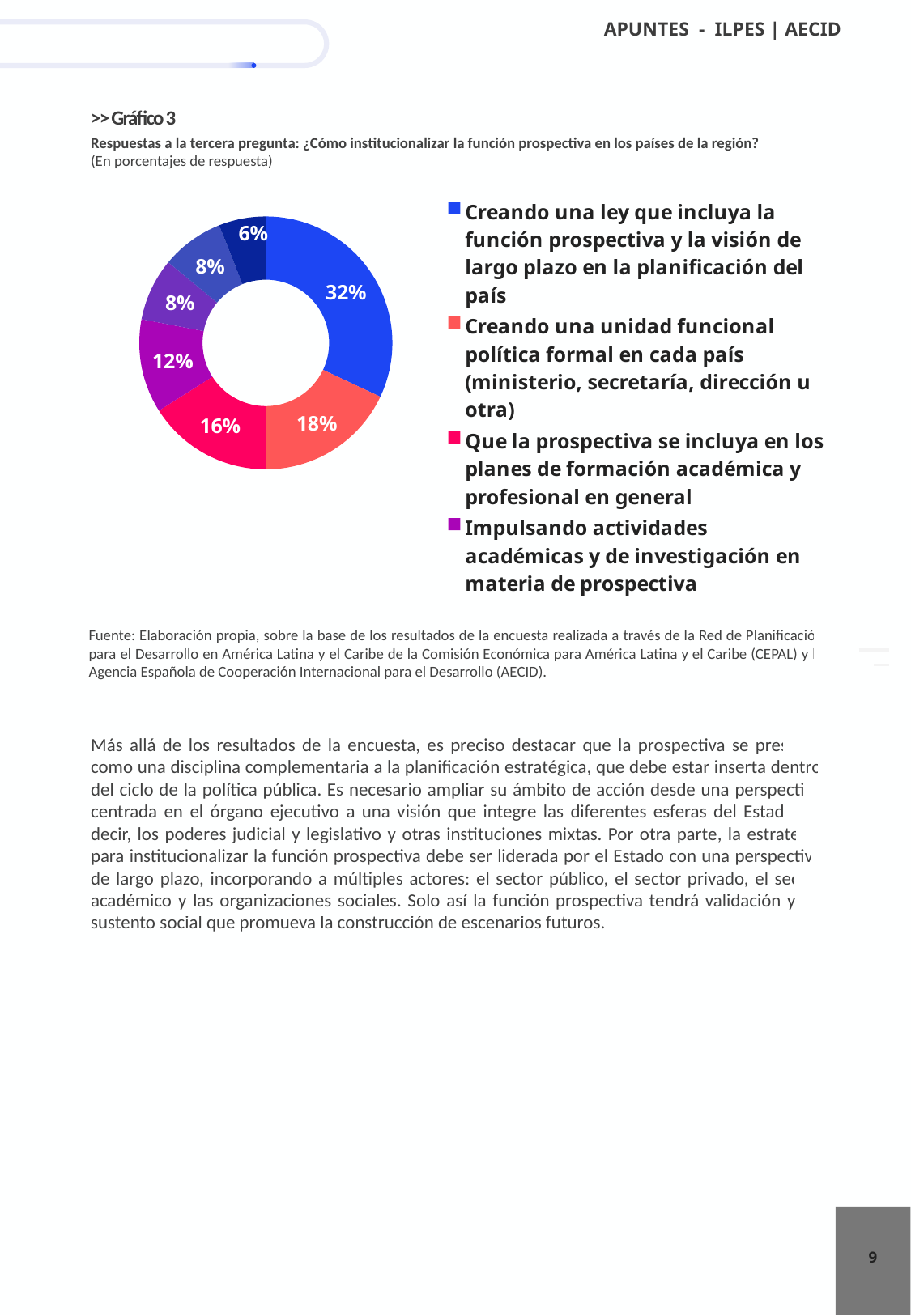
What is the smallest percentage shown on the pie chart? 6% What percentage of responses corresponds to 'Creando una ley que incluya la función prospectiva y la visión de largo plazo en la planificación del país'? 32% Which response option has the largest share of the pie? Creando una ley que incluya la función prospectiva y la visión de largo plazo en la planificación del país What is the difference in percentage points between 'Creando una ley...' (32%) and 'Creando una unidad funcional...' (18%)? 14 percentage points How many slices does the pie chart have? 7 How many legend entries are shown next to the pie chart? 4 What percentage of responses corresponds to 'Impulsando actividades académicas y de investigación en materia de prospectiva'? 12% Which has a larger share: 'Creando una unidad funcional política formal en cada país' or 'Que la prospectiva se incluya en los planes de formación académica y profesional en general'? Creando una unidad funcional política formal en cada país What kind of chart is shown in Gráfico 3? Pie (donut) chart What percentage of responses corresponds to 'Que la prospectiva se incluya en los planes de formación académica y profesional en general'? 16% How many slices of the pie chart are labelled 8%? 2 What percentage of responses corresponds to 'Creando una unidad funcional política formal en cada país (ministerio, secretaría, dirección u otra)'? 18%